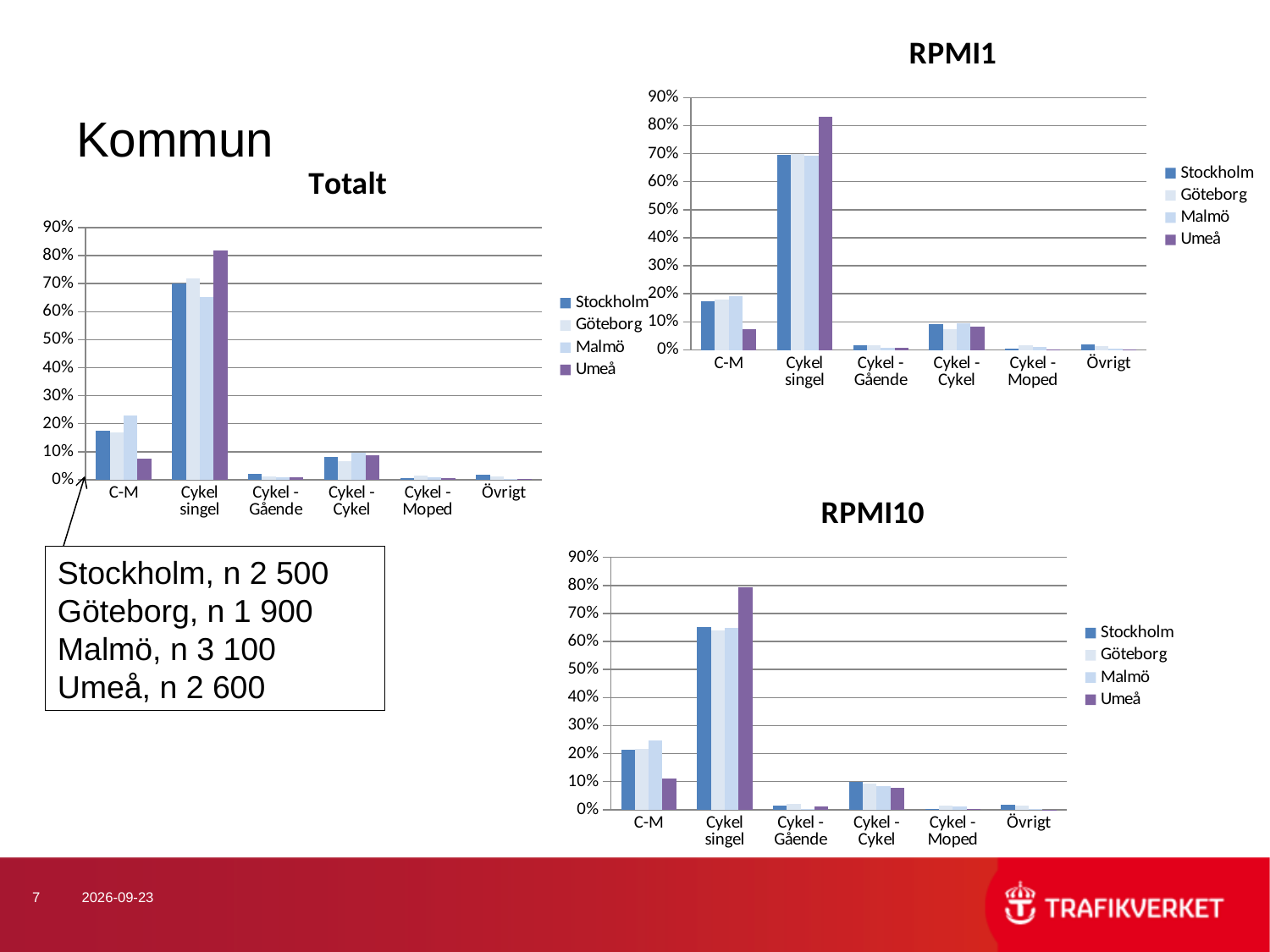
In the 'Totalt' chart, which series has the highest value for 'Cykel singel'? Umeå In the 'RPMI10' chart, which series has the highest value for 'Cykel singel'? Umeå In the 'Totalt' chart, which is larger: Malmö's value for 'C-M' or Umeå's value for 'C-M'? Malmö In the 'Totalt' chart, which series has the lowest value for 'C-M'? Umeå In the 'Totalt' chart, what kind of chart is shown? bar chart In the 'RPMI10' chart, is the value for Umeå in 'C-M' greater or less than 20%? less In the 'RPMI1' chart, which is larger for Umeå: the value for 'C-M' or the value for 'Cykel singel'? Cykel singel What is the title of the chart in the top right of the slide? RPMI1 In the 'Totalt' chart, how many series does the legend list? 4 In the 'RPMI1' chart, how many categories are shown on the x axis? 6 In the 'RPMI10' chart, is the value for Stockholm in 'Cykel singel' greater or less than 60%? greater In the 'RPMI1' chart, is the value for Umeå in 'Cykel singel' greater or less than 80%? greater